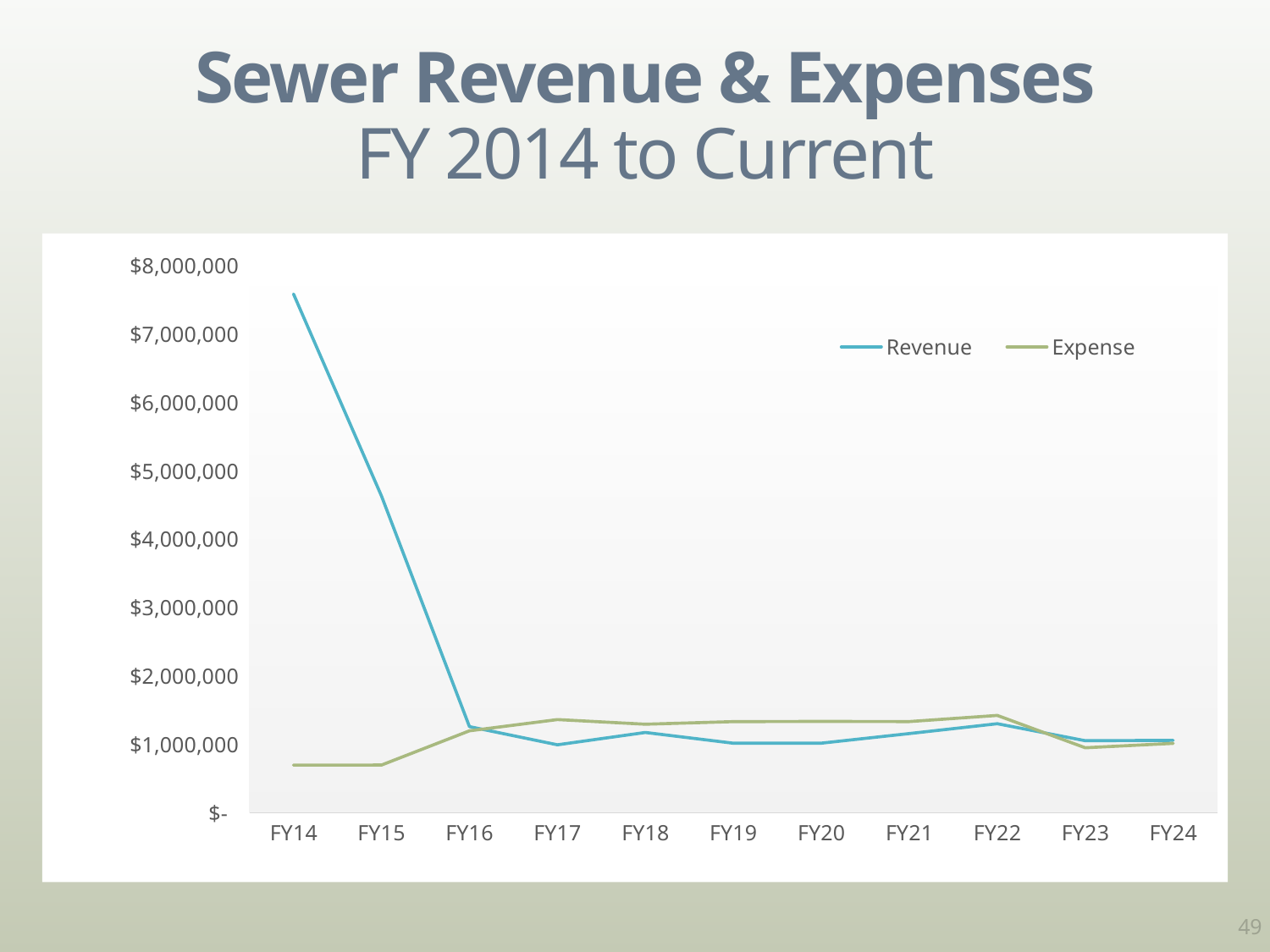
In FY14, which is larger, Revenue or Expense? Revenue Does Revenue rise or fall from FY14 to FY16? falls Is the Revenue value for FY14 greater or less than $7,000,000? greater Is the Expense value for FY14 greater or less than $1,000,000? less How many series does the legend list? 2 Is the Expense value for FY17 greater or less than $1,000,000? greater What colour is the Revenue line in the legend? blue In which fiscal year is Revenue highest? FY14 In FY17, which is larger, Revenue or Expense? Expense How many fiscal years are plotted along the x axis? 11 What kind of chart is shown on the slide? line chart